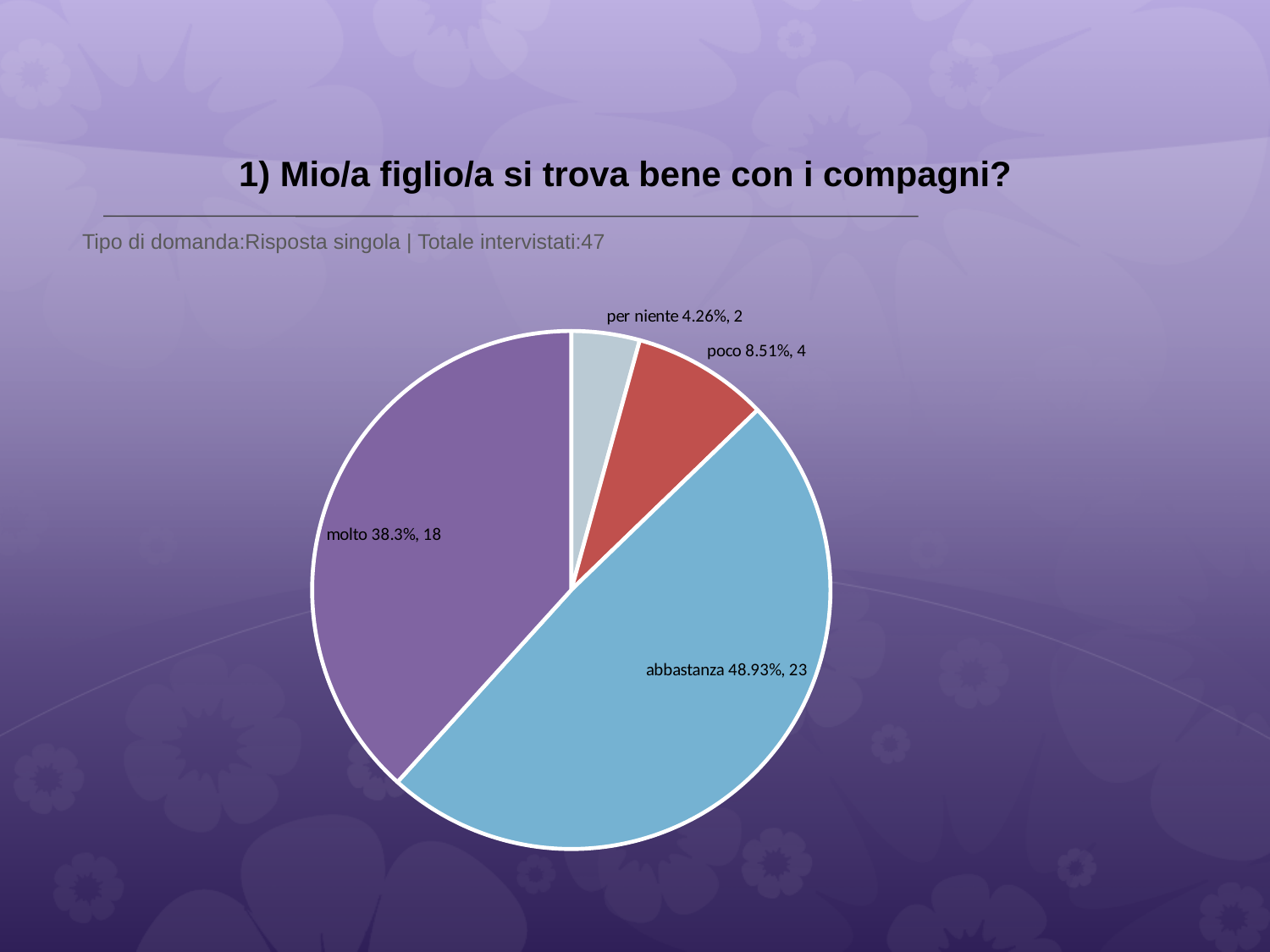
How many respondents answered 'molto'? 18 Which category has the smallest slice? per niente How many slices does the pie chart have? 4 What is the difference in respondent count between 'abbastanza' and 'molto'? 5 What kind of chart is shown on the slide? pie chart What is the total number of respondents stated on the slide? 47 Which category has the largest slice? abbastanza How many respondents answered 'per niente'? 2 What percentage share does the 'abbastanza' slice have? 48.93% Which has more respondents, 'poco' or 'per niente'? poco How many respondents answered 'poco'? 4 What percentage share does the 'molto' slice have? 38.3%